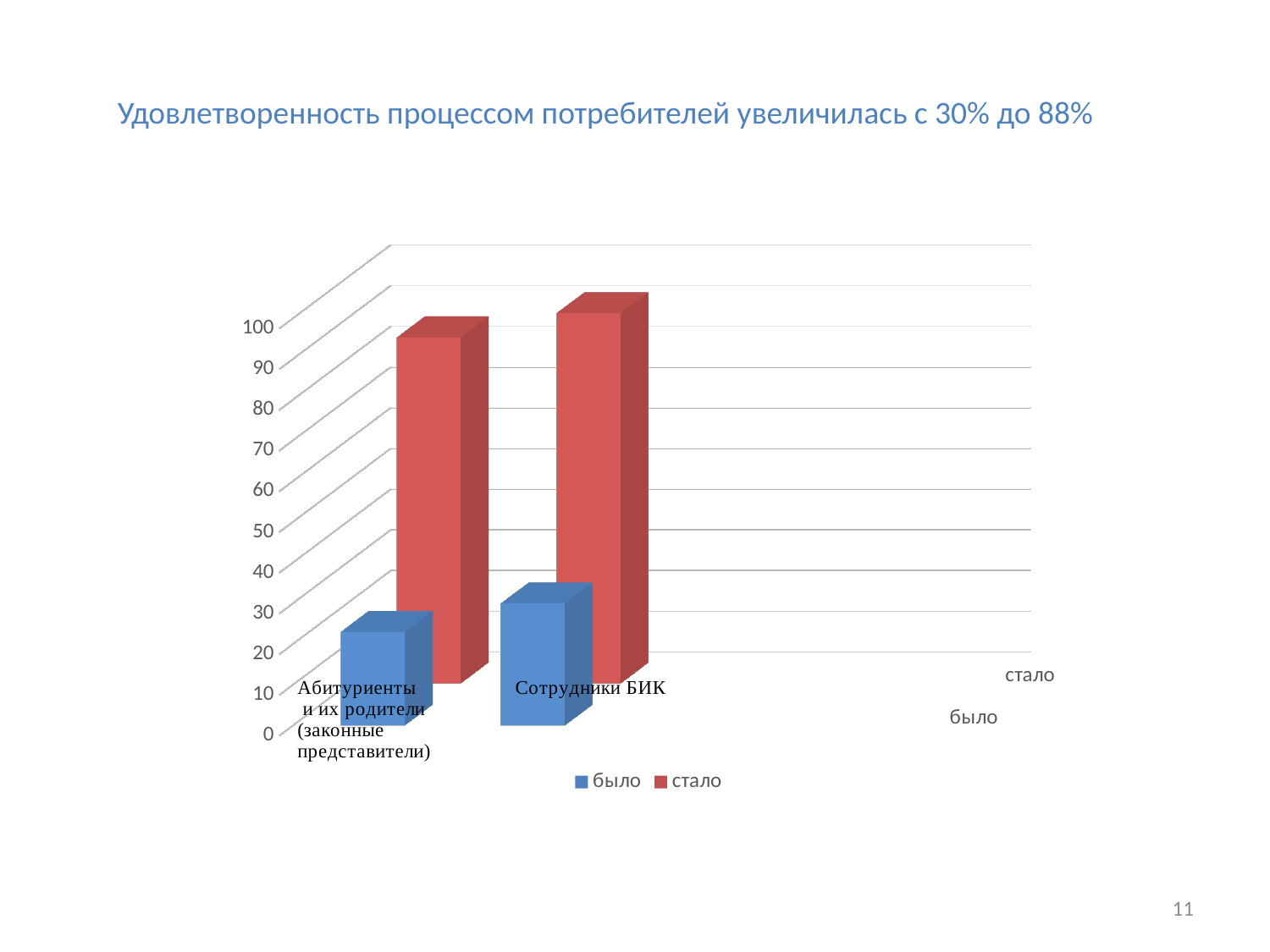
For "Абитуриенты и их родители (законные представители)", which series has the larger value, "было" or "стало"? стало Is the value of "было" for "Абитуриенты и их родители (законные представители)" greater or less than 40? less What kind of chart is shown on the slide? bar chart How many series does the legend list? 2 Which category has the higher "было" value, "Абитуриенты и их родители (законные представители)" or "Сотрудники БИК"? Сотрудники БИК Is the value of "было" for "Сотрудники БИК" greater or less than 50? less Is the value of "стало" for "Абитуриенты и их родители (законные представители)" greater or less than 60? greater How many categories are shown on the x axis of the chart? 2 What are the two series named in the legend? было, стало What is the title of the slide above the chart? Удовлетворенность процессом потребителей увеличилась с 30% до 88% For "Сотрудники БИК", which series has the larger value, "было" or "стало"? стало